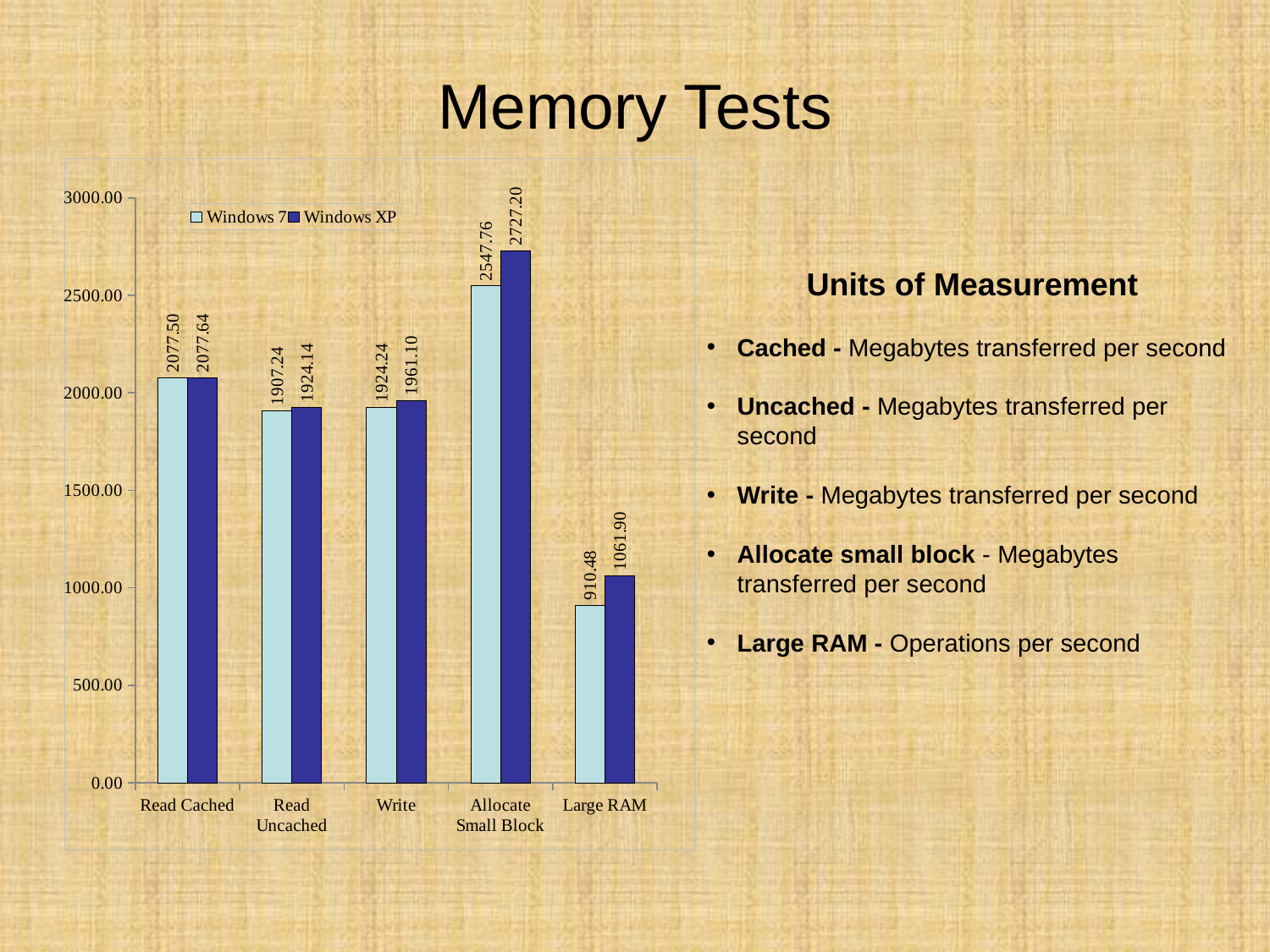
How many series does the legend list? 2 What kind of chart is shown on the slide? Bar chart What is the Windows XP value for Write? 1961.10 For Allocate Small Block, which is larger: the Windows 7 value or the Windows XP value? Windows XP Which category has the highest Windows XP value? Allocate Small Block What is the Windows 7 value for Read Uncached? 1907.24 Which category has the lowest Windows 7 value? Large RAM How many categories are shown on the x axis? 5 What is the difference between the Windows XP and Windows 7 values for Allocate Small Block? 179.44 What is the Windows XP value for Large RAM? 1061.90 What is the Windows 7 value for Allocate Small Block? 2547.76 What is the difference between the Windows XP and Windows 7 values for Large RAM? 151.42